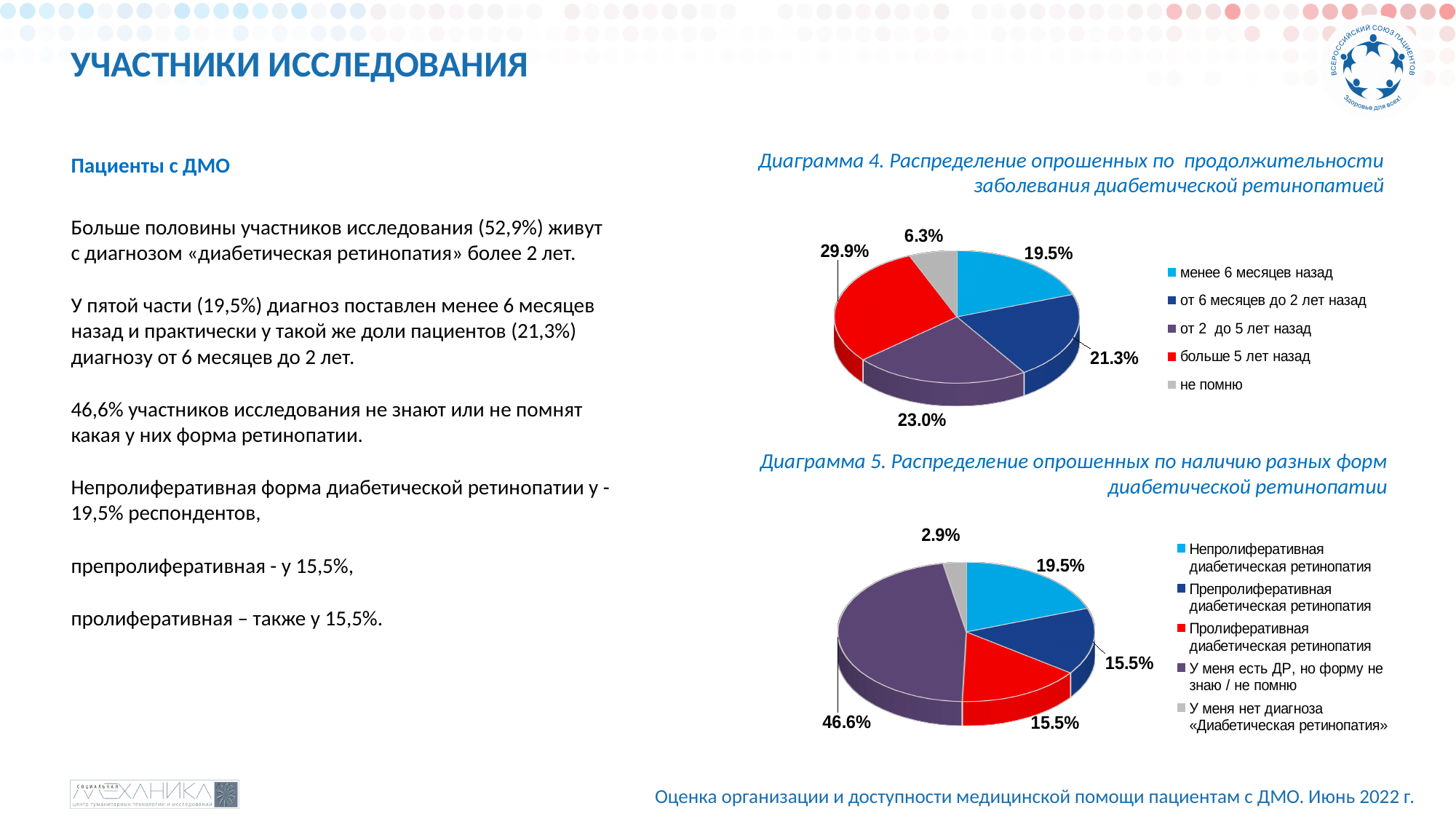
In Диаграмма 5, what share of respondents have «Непролиферативная диабетическая ретинопатия»? 19.5% In Диаграмма 4, what is the difference between the shares for «от 2 до 5 лет назад» and «менее 6 месяцев назад»? 3.5% In Диаграмма 4, which category has the largest share? больше 5 лет назад In Диаграмма 5, what share of respondents answered «У меня есть ДР, но форму не знаю / не помню»? 46.6% How many categories does the legend of Диаграмма 4 list? 5 In Диаграмма 5, which category has the smallest share? У меня нет диагноза «Диабетическая ретинопатия» In Диаграмма 4, what share of respondents answered «не помню»? 6.3% What kind of chart is Диаграмма 5? Pie chart In Диаграмма 4, what colour is the slice for «от 6 месяцев до 2 лет назад»? Dark blue In Диаграмма 5, which is larger: the share for «Непролиферативная диабетическая ретинопатия» or for «Пролиферативная диабетическая ретинопатия»? Непролиферативная диабетическая ретинопатия In Диаграмма 4, what share of respondents answered «больше 5 лет назад»? 29.9% In Диаграмма 4, which category has the smallest share? не помню